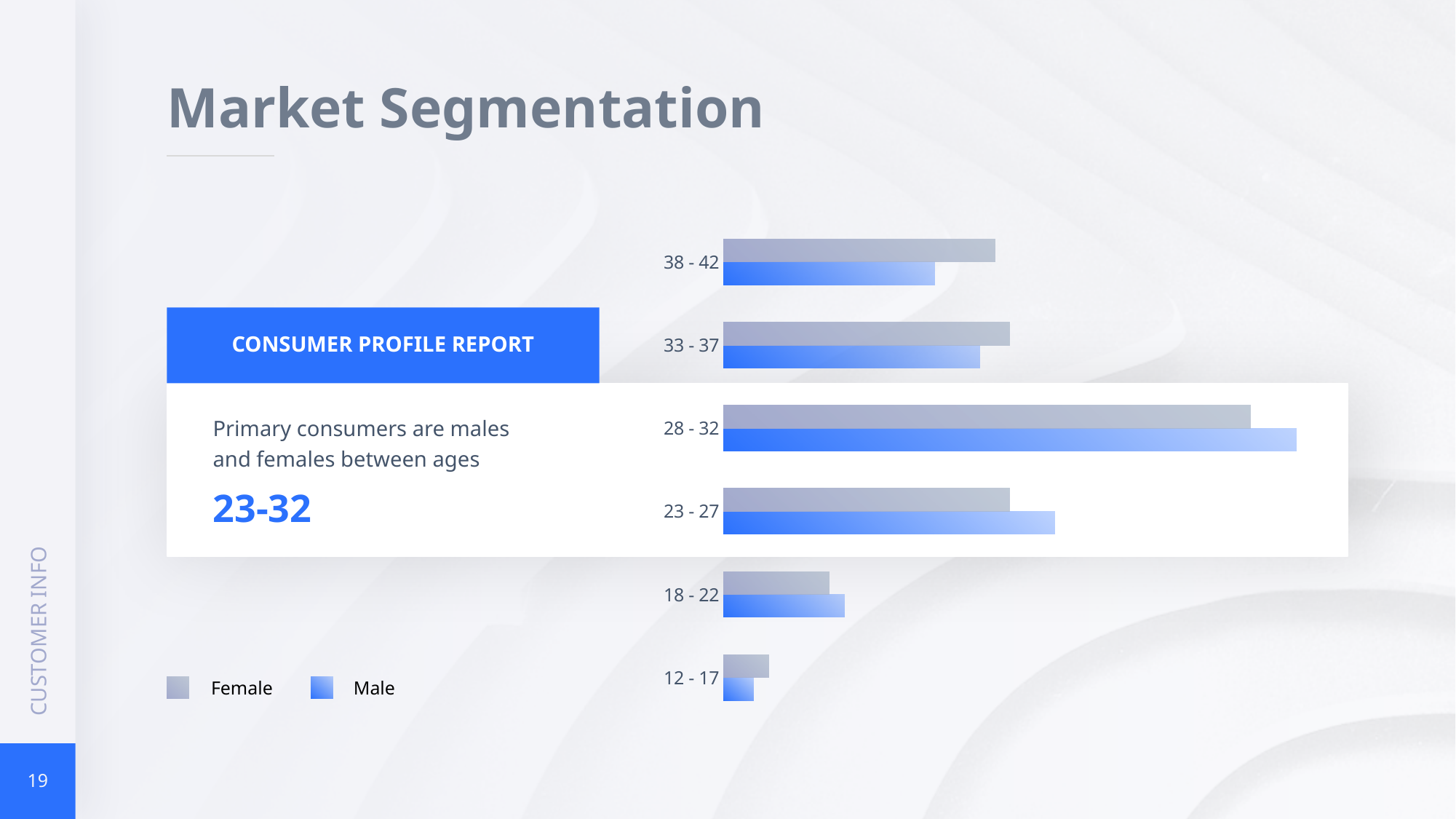
For the 23 - 27 age group, which is larger, the Female or the Male value? Male Do the Male values rise or fall going from the 12 - 17 group to the 28 - 32 group? rise For the 28 - 32 age group, which is larger, the Female or the Male value? Male Which age group has the longest Female bar? 28 - 32 Which age group has the shortest Female bar? 12 - 17 For the 38 - 42 age group, which is larger, the Female or the Male value? Female Which age group has the longest Male bar? 28 - 32 Which age group has the shortest Male bar? 12 - 17 How many series does the legend list? 2 Which two series are listed in the chart legend? Female and Male How many age groups are shown in the chart? 6 What kind of chart is shown on the slide? bar chart